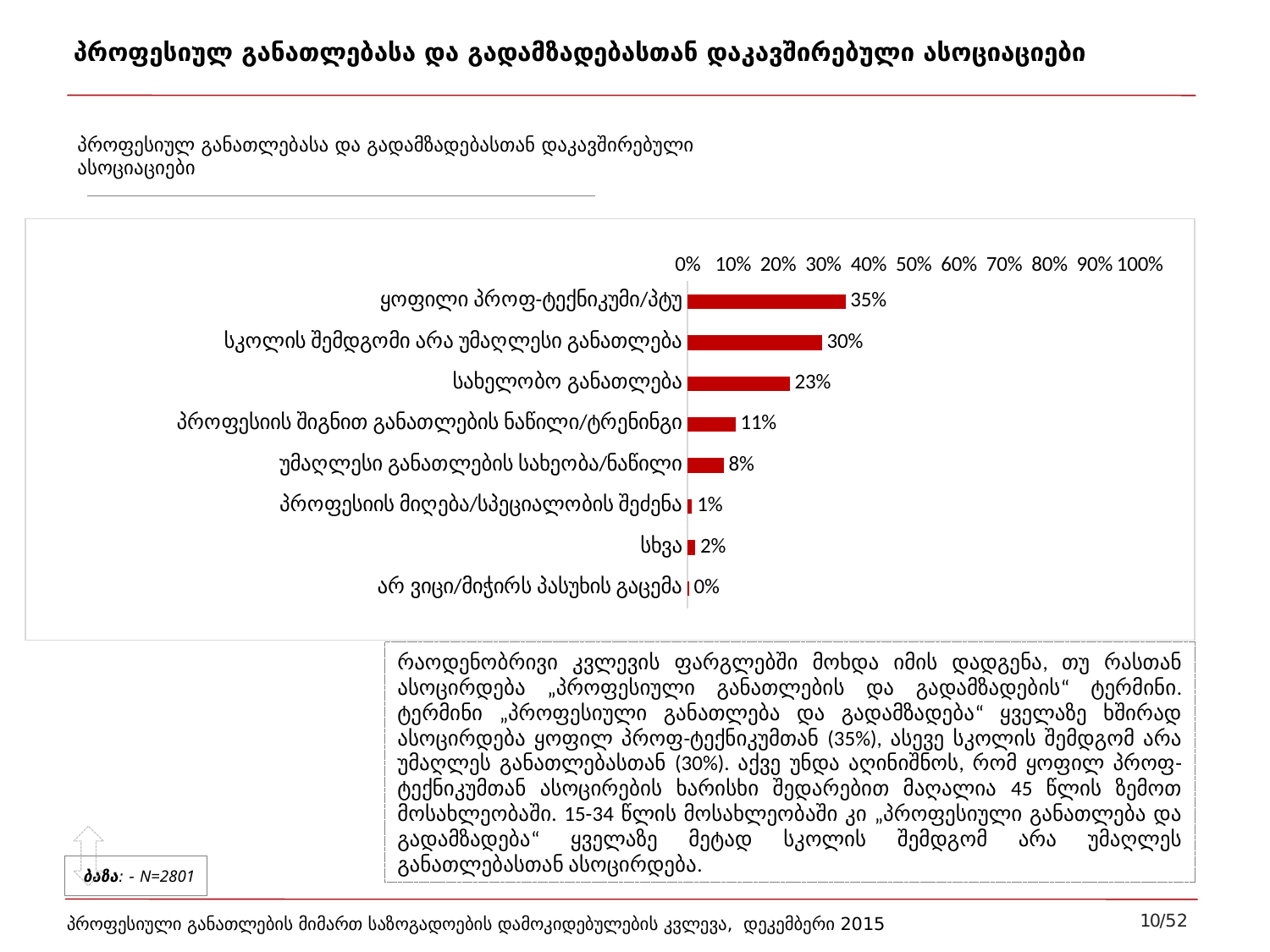
What is the value for "სახელობო განათლება"? 23% Which is larger: the value for "პროფესიის შიგნით განათლების ნაწილი/ტრენინგი" or the value for "უმაღლესი განათლების სახეობა/ნაწილი"? პროფესიის შიგნით განათლების ნაწილი/ტრენინგი What is the value for "უმაღლესი განათლების სახეობა/ნაწილი"? 8% What is the value for "სხვა"? 2% Is the value for "სკოლის შემდგომი არა უმაღლესი განათლება" greater or less than 20%? greater How many categories are shown in the chart? 8 Which category has the lowest value? არ ვიცი/მიჭირს პასუხის გაცემა What is the value for "ყოფილი პროფ-ტექნიკუმი/პტუ"? 35% Which category has the highest value? ყოფილი პროფ-ტექნიკუმი/პტუ What is the title of the chart? პროფესიულ განათლებასა და გადამზადებასთან დაკავშირებული ასოციაციები What kind of chart is shown on the slide? bar chart What is the difference between the values for "ყოფილი პროფ-ტექნიკუმი/პტუ" and "სკოლის შემდგომი არა უმაღლესი განათლება"? 5%